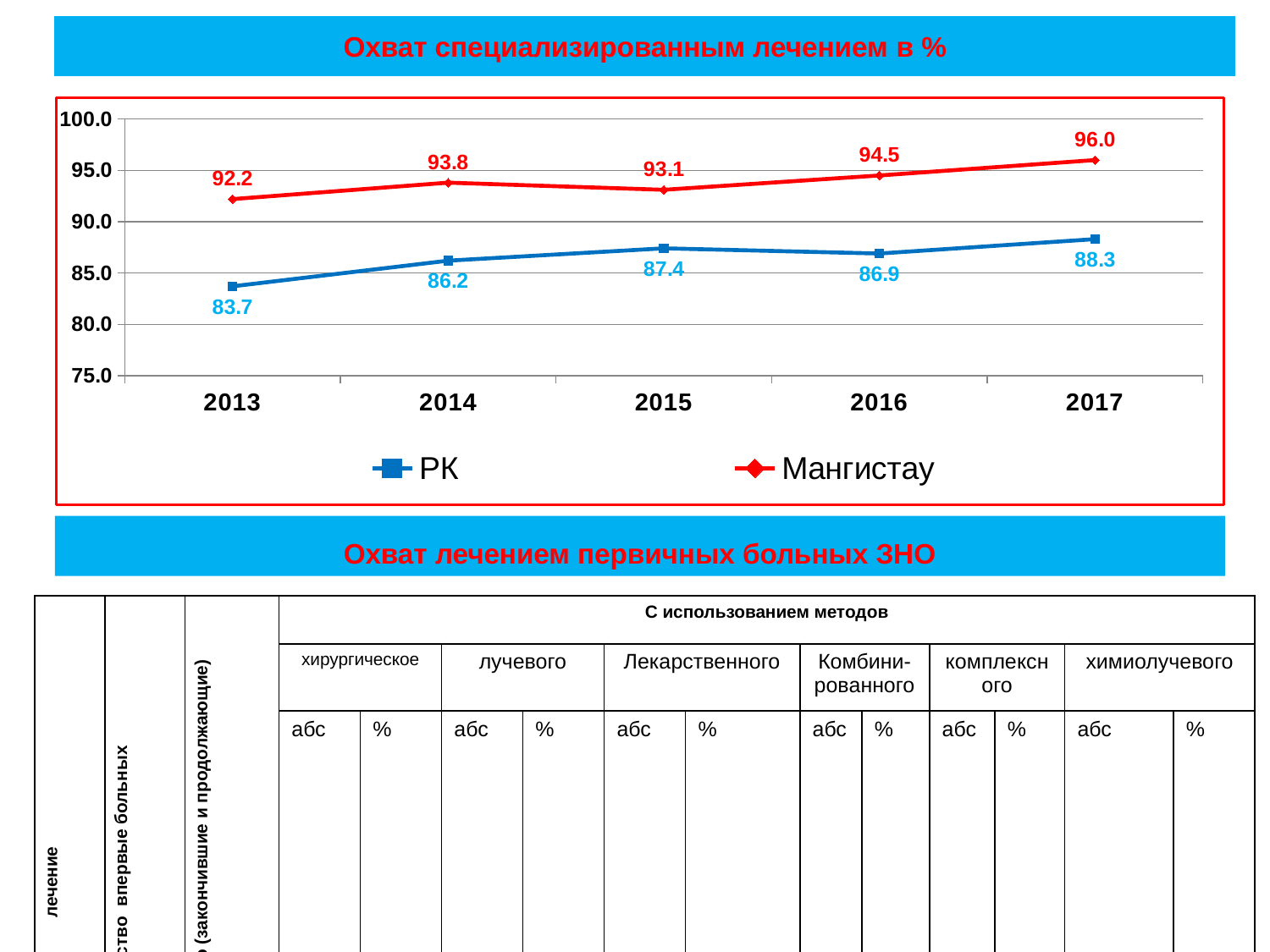
In which year is the value for РК the highest? 2017 What is the value for Мангистау in 2014? 93.8 How many series does the chart legend list? 2 In which year is the value for Мангистау the lowest? 2013 Is the value for РК in 2014 greater or less than 90.0? less Which is larger in 2015: the value for РК or the value for Мангистау? Мангистау What is the difference between the Мангистау and РК values in 2016? 7.6 What is the value for РК in 2015? 87.4 How many years are shown on the x axis of the chart? 5 What type of chart is shown on the slide? line chart What is the value for РК in 2013? 83.7 What is the value for Мангистау in 2017? 96.0